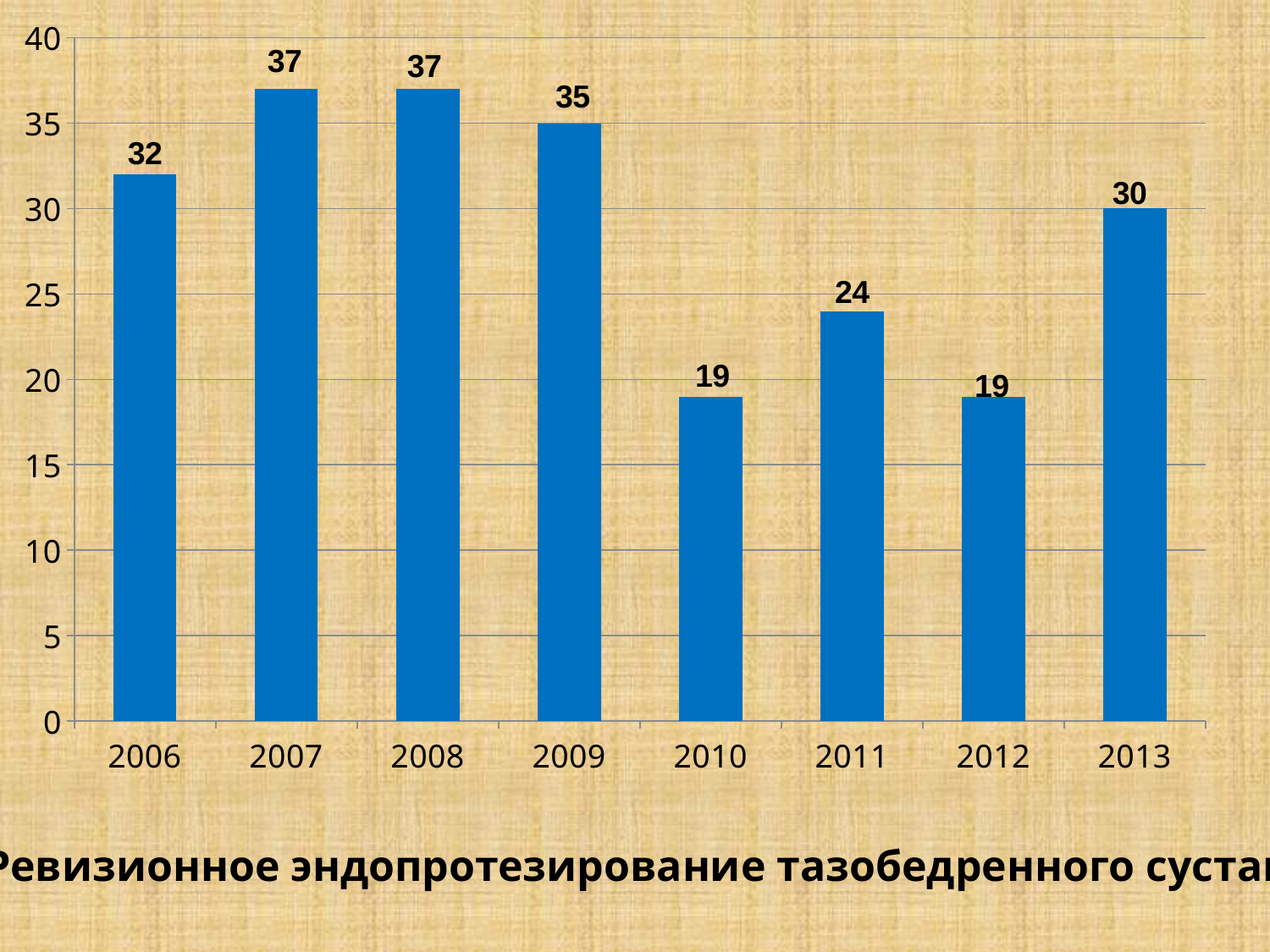
How many years are shown on the x axis? 8 What is the value for 2013? 30 Which years share the highest value? 2007 and 2008 Which year has the lowest value? 2010 and 2012 What is the value for 2006? 32 Which is larger, the value for 2006 or the value for 2013? 2006 What is the difference between the values for 2009 and 2010? 16 What is the difference between the values for 2013 and 2012? 11 What kind of chart is this? bar chart Do the values rise or fall from 2009 to 2010? fall Is the value for 2011 greater or less than 25? less What is the value for 2011? 24